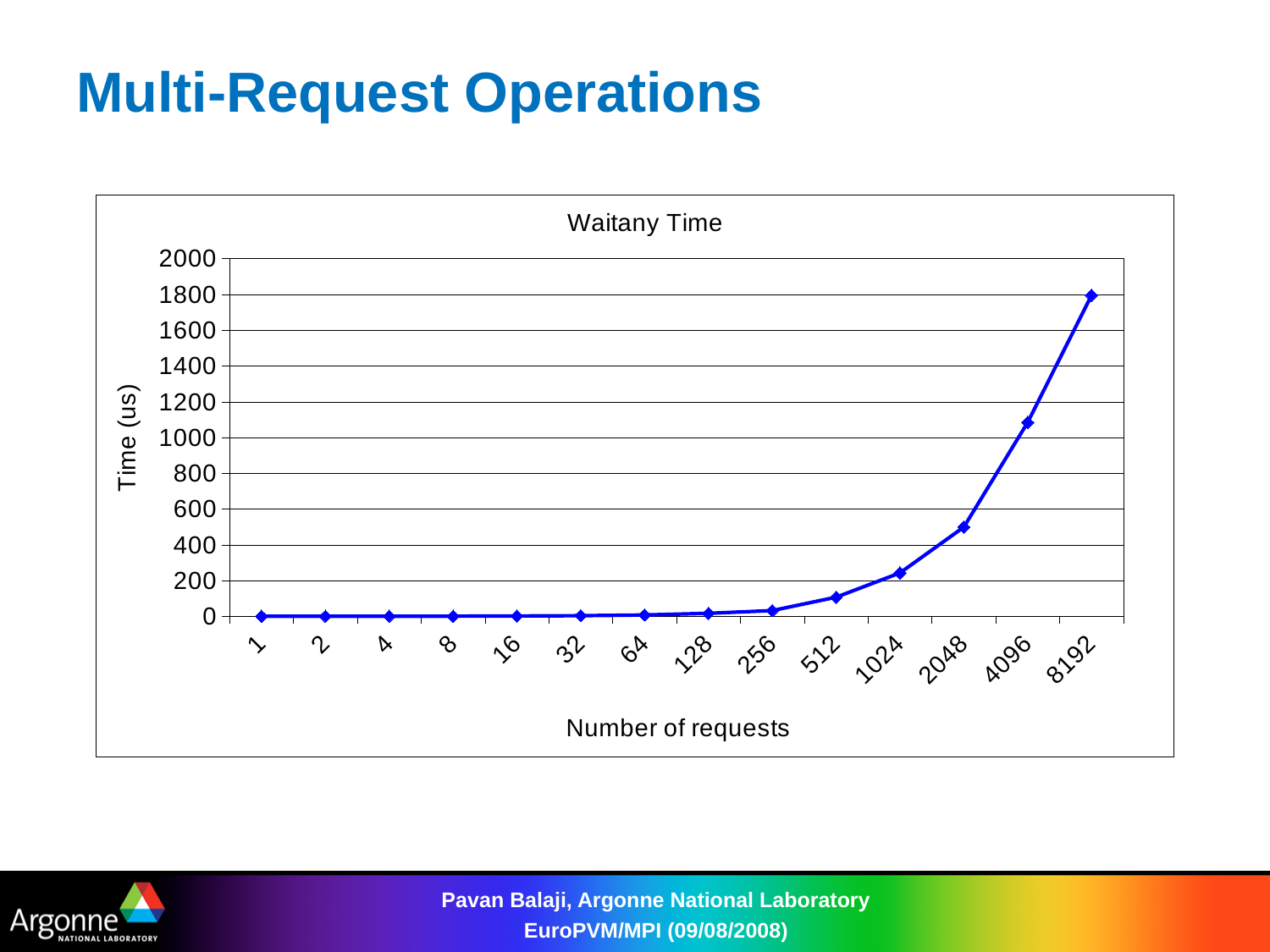
What is the title of the chart? Waitany Time Do the values rise or fall as the number of requests increases along the x axis? rise Which number of requests has the highest Waitany time? 8192 What kind of chart is shown on the slide? line chart Which has the larger Waitany time, 2048 requests or 4096 requests? 4096 What is the label of the y axis? Time (us) Is the value for 2048 requests greater or less than 600? less Is the value for 4096 requests greater or less than 1000? greater Is the value for 8192 requests greater or less than 1600? greater Which has the larger Waitany time, 512 requests or 1024 requests? 1024 How many data points are plotted along the x axis? 14